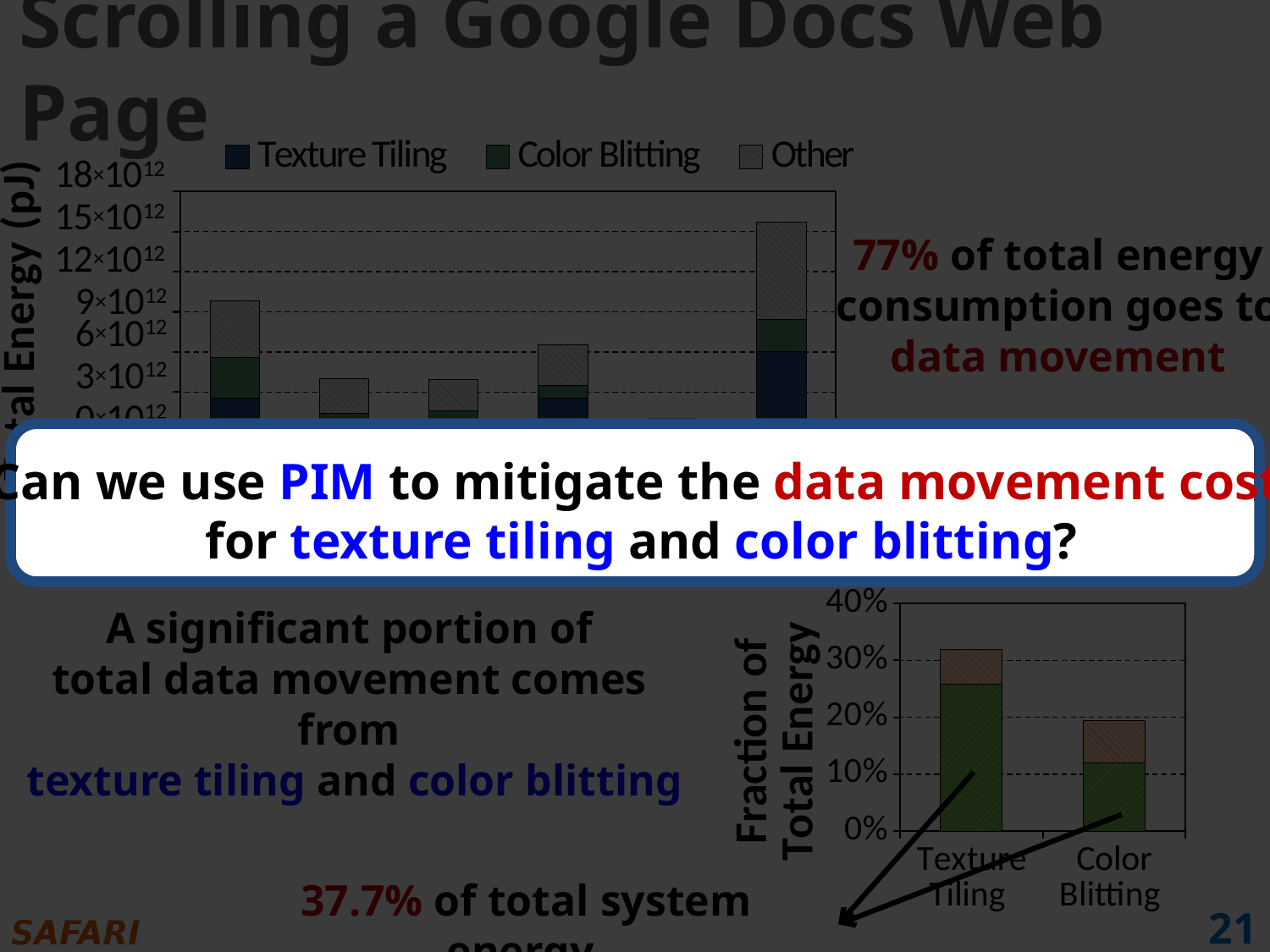
What kind of chart is the top chart? Stacked bar chart In the bottom-right chart, is the value for Texture Tiling greater or less than 20%? greater In the top chart, is the total of the rightmost bar greater or less than 12×10^12 pJ? greater What is the y-axis label of the bottom-right chart? Fraction of Total Energy In the bottom-right chart, which category has the higher fraction of total energy? Texture Tiling In the top chart, how many series does the legend list? 3 In the top chart, how many bars are plotted? 6 In the bottom-right chart, how many categories are shown on the x axis? 2 In the top chart, what are the three legend entries? Texture Tiling, Color Blitting, Other In the top chart, which bar has the highest total energy? The rightmost bar What kind of chart is the bottom-right chart? Bar chart In the top chart, is the total of the leftmost bar greater or less than 12×10^12 pJ? less